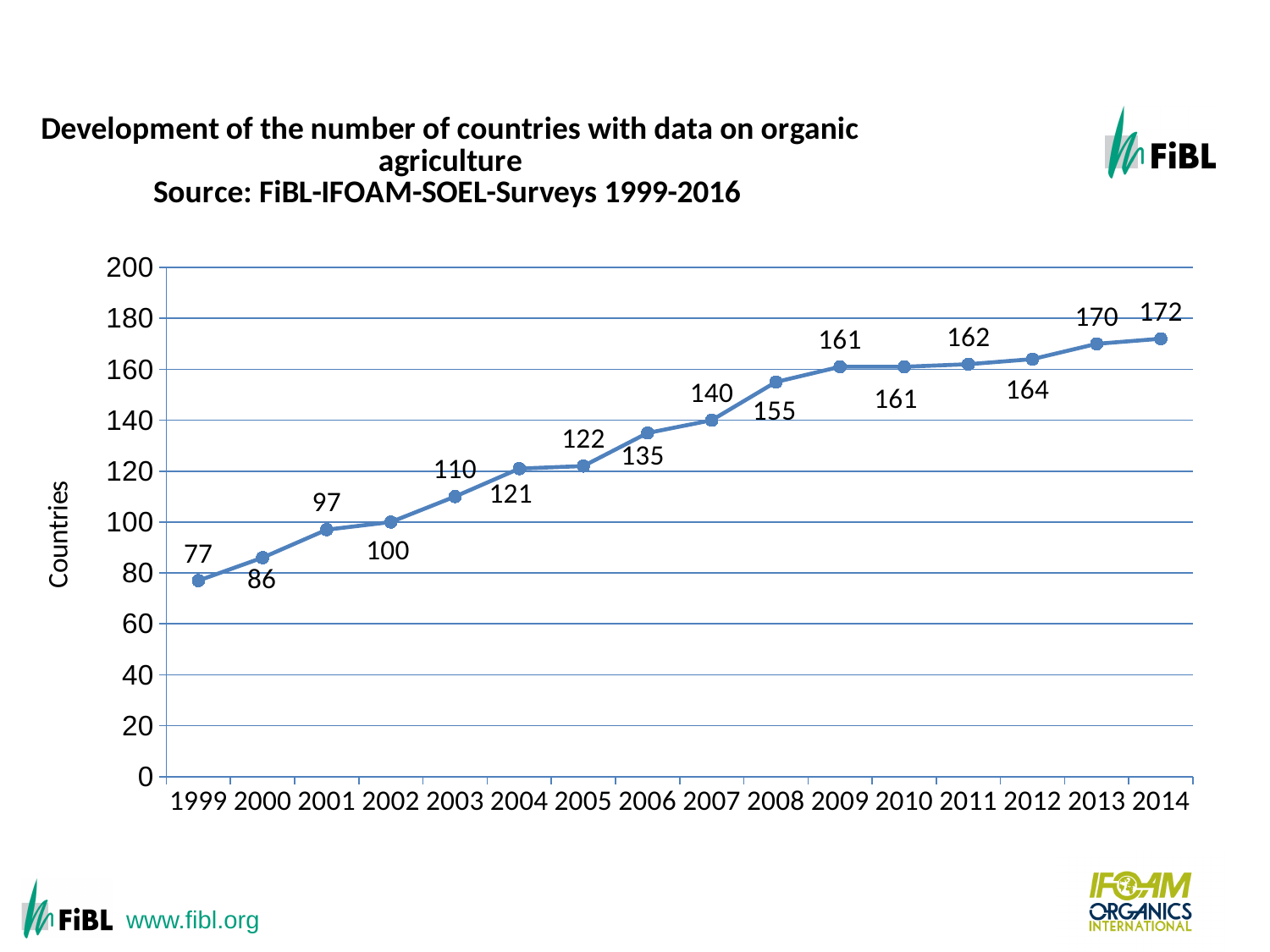
Which year has the highest number of countries? 2014 Is the value for 2006 greater or less than 120? greater Does the number of countries generally rise or fall from 1999 to 2014? rise What is the difference in the number of countries between 2008 and 2007? 15 What is the number of countries with data on organic agriculture in 2014? 172 What is the number of countries with data on organic agriculture in 1999? 77 What is the difference in the number of countries between 2014 and 1999? 95 Which year has the lowest number of countries? 1999 How many years are plotted on the x axis? 16 Which year has more countries, 2003 or 2005? 2005 What is the number of countries with data on organic agriculture in 2008? 155 What kind of chart is shown on the slide? line chart